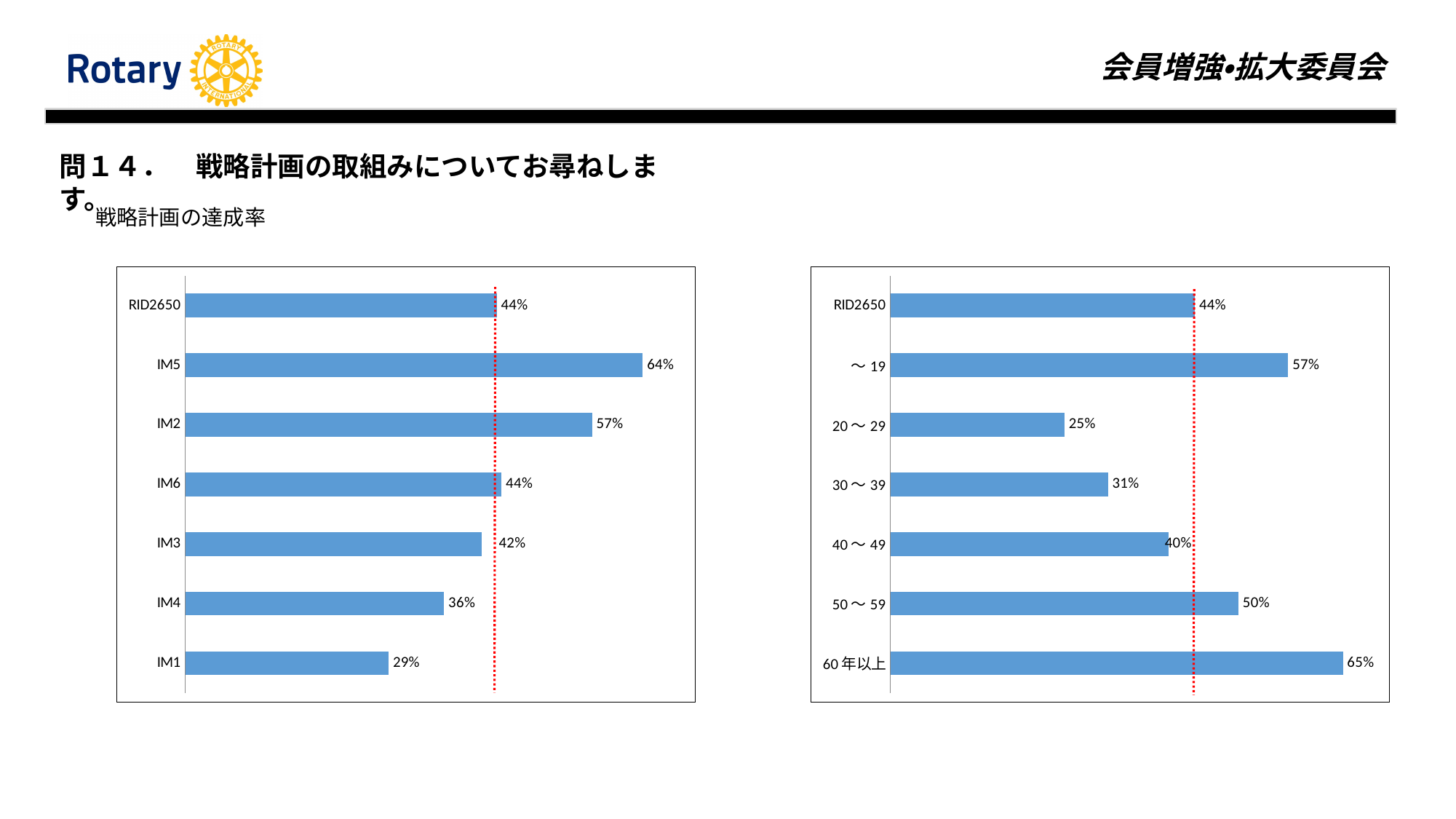
In the right chart, what is the value for 60年以上? 65% In the right chart, which is larger, the value for 50～59 or the value for 40～49? 50～59 What kind of chart is the right chart? Bar chart In the left chart, which category has the lowest value? IM1 In the right chart, what is the difference between the values for 60年以上 and RID2650? 21% In the left chart, what is the difference between the values for IM2 and IM4? 21% In the left chart, what is the value for IM1? 29% In the left chart, how many categories are plotted? 7 In the left chart, which category has the highest value? IM5 In the right chart, which category has the lowest value? 20～29 In the right chart, what is the value for 20～29? 25% In the left chart, what is the value for IM5? 64%